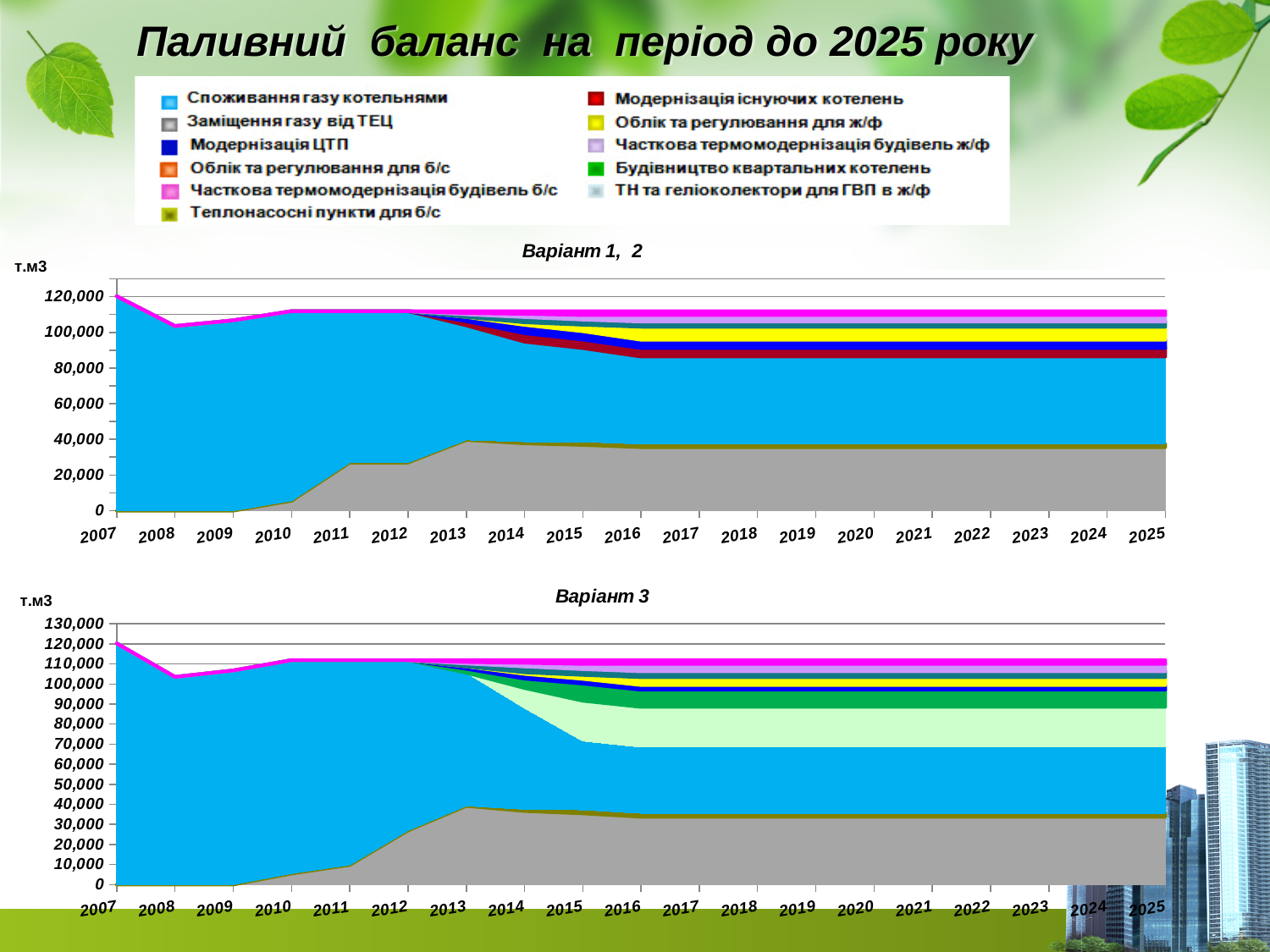
In the 'Варіант 1, 2' chart, does the 'Заміщення газу від ТЕЦ' area rise or fall from 2009 to 2013? rise How many series does the legend at the top of the slide list? 11 How many years are shown on the x axis of the 'Варіант 3' chart? 19 What unit is shown on the y axis of both charts? т.м3 In the 'Варіант 1, 2' chart, is the total stacked value in 2008 greater or less than 120,000? less In the 'Варіант 3' chart, is the 'Заміщення газу від ТЕЦ' area in 2025 greater or less than 40,000? less In the 'Варіант 1, 2' chart, what is the value for 'Заміщення газу від ТЕЦ' in 2007? 0 What is the title of the lower chart? Варіант 3 What kind of chart is the 'Варіант 1, 2' chart? Area chart In the 'Варіант 3' chart, is the top of the 'Споживання газу котельнями' area in 2025 greater or less than 80,000? less In the 'Варіант 3' chart, does the total stacked value rise or fall from 2007 to 2008? fall